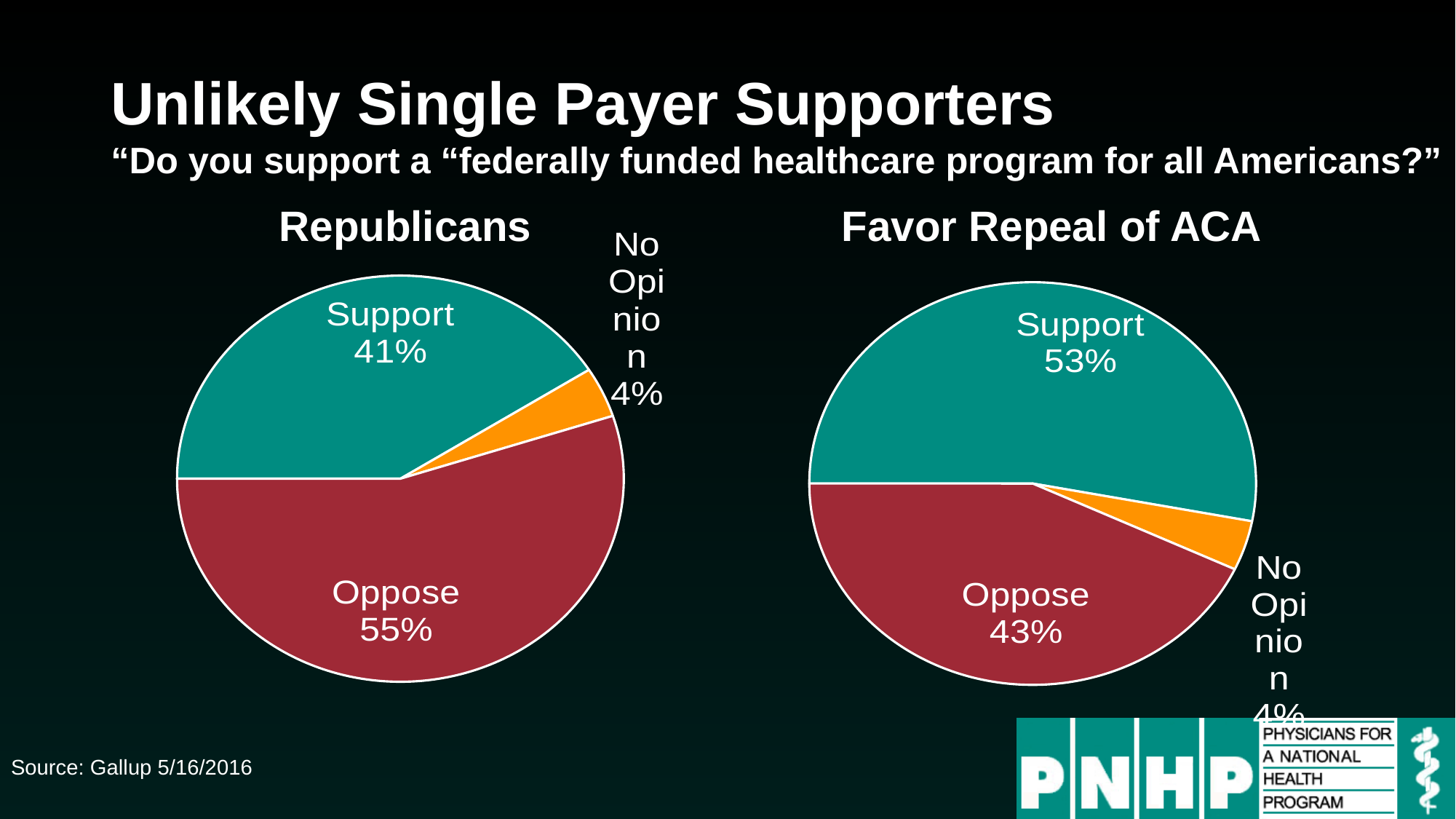
Which is larger: the Support share in the Republicans chart or the Support share in the Favor Repeal of ACA chart? Favor Repeal of ACA In the Republicans chart, what percentage oppose? 55% In the Favor Repeal of ACA chart, which slice is the smallest? No Opinion In the Republicans chart, which slice is the largest? Oppose In the Republicans chart, what percentage of respondents support a federally funded healthcare program for all Americans? 41% What type of chart is used on this slide? Pie chart In the Favor Repeal of ACA chart, which slice is the largest? Support In the Favor Repeal of ACA chart, what percentage oppose? 43% In the Republicans chart, what percentage have no opinion? 4% How many slices does the Republicans pie chart have? 3 In the Republicans chart, what is the difference between the Oppose and Support percentages? 14% In the Favor Repeal of ACA chart, what percentage support? 53%